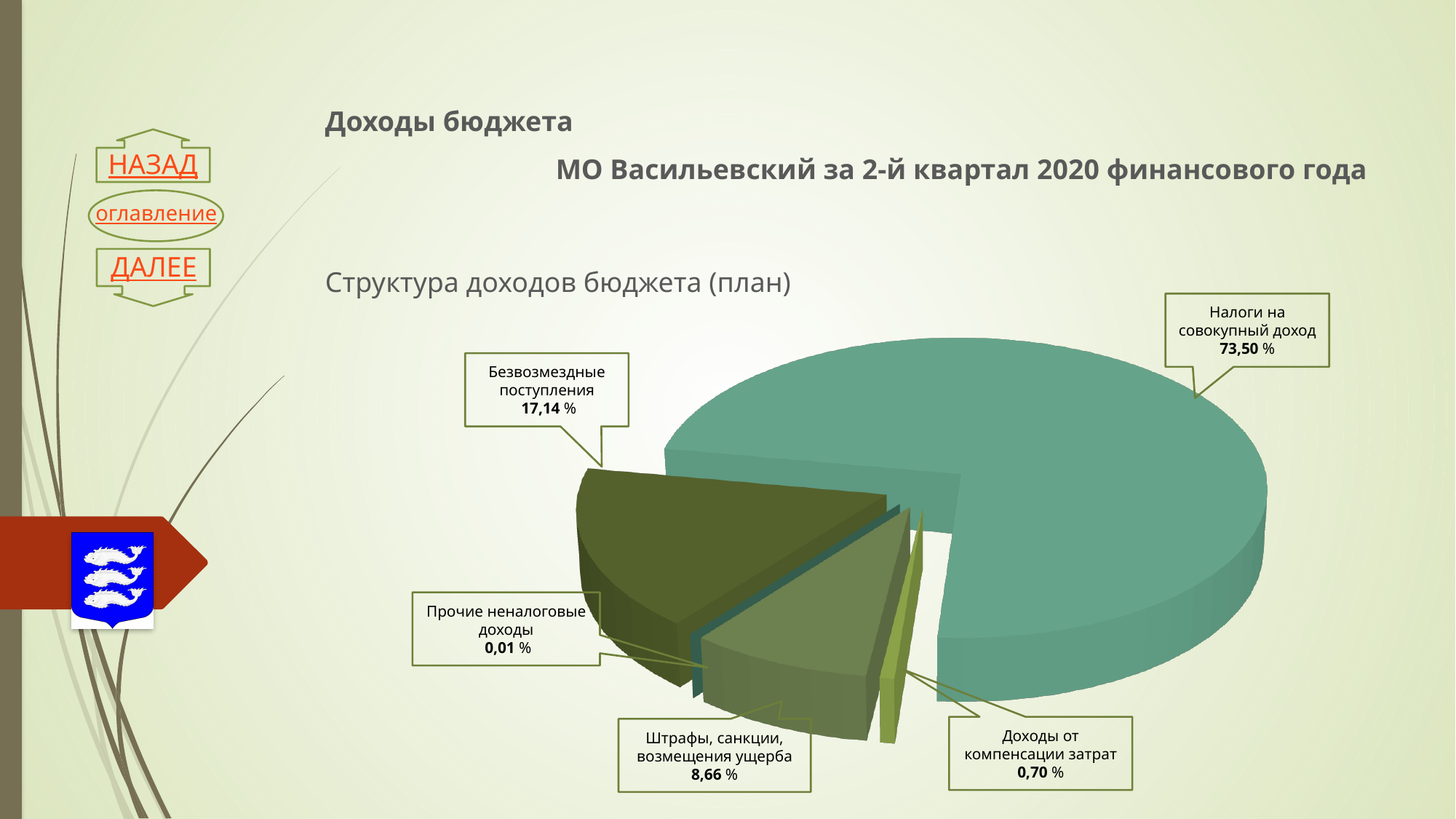
What is the difference between the shares of Безвозмездные поступления and Штрафы, санкции, возмещения ущерба? 8,48 % How many slices does the pie chart have? 5 What share of the pie is labelled for Налоги на совокупный доход? 73,50 % Which is larger: the share of Доходы от компенсации затрат or the share of Штрафы, санкции, возмещения ущерба? Штрафы, санкции, возмещения ущерба What is the title of the chart? Структура доходов бюджета (план) What value is shown for Прочие неналоговые доходы? 0,01 % What type of chart is shown on the slide? Pie chart What value is shown for Штрафы, санкции, возмещения ущерба? 8,66 % What value is shown for Доходы от компенсации затрат? 0,70 % What value is shown for Безвозмездные поступления? 17,14 % Which category has the largest share of the pie? Налоги на совокупный доход Which category has the smallest share of the pie? Прочие неналоговые доходы